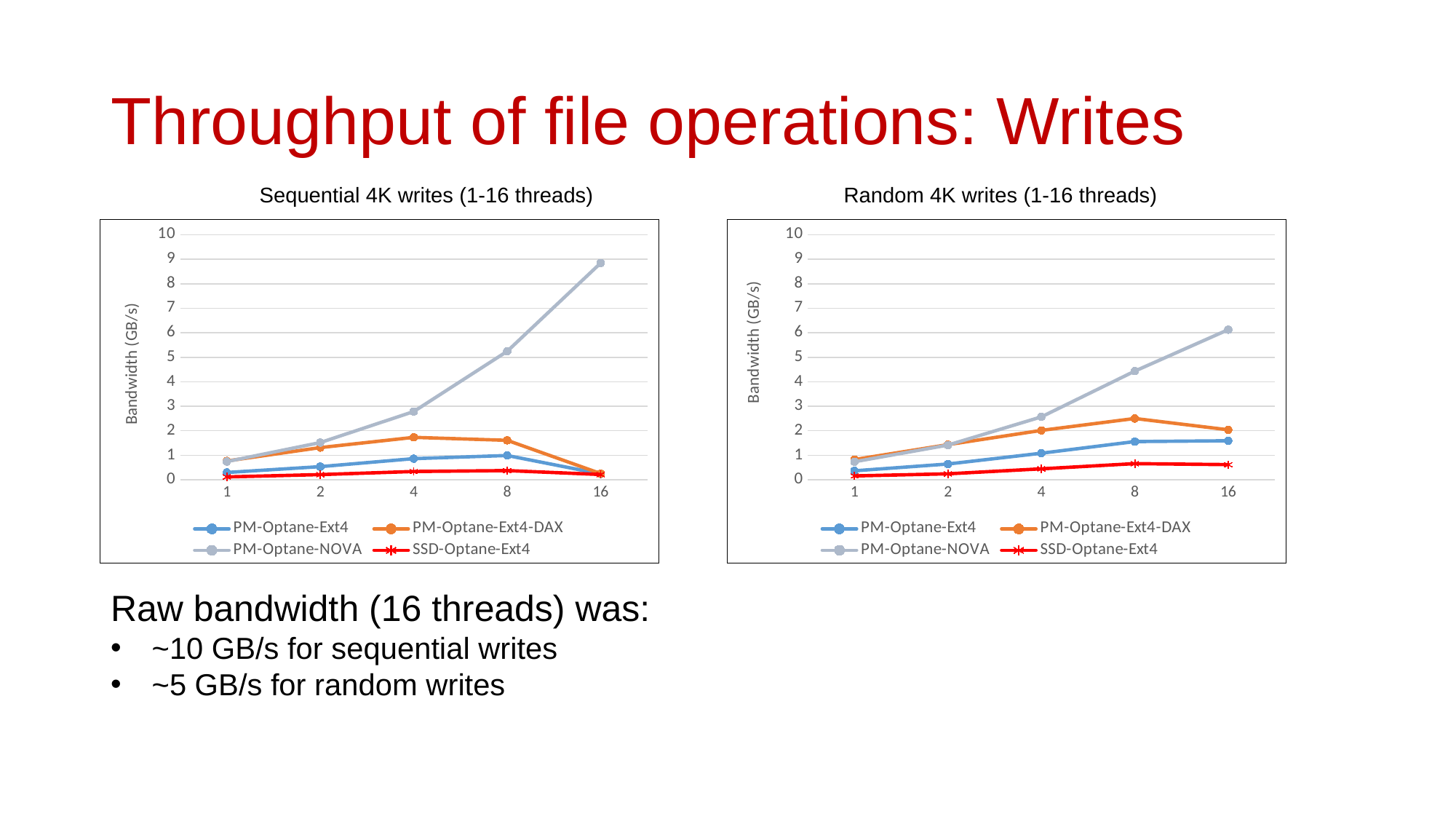
In the Sequential 4K writes (1-16 threads) chart, which series has the highest bandwidth at 16 threads? PM-Optane-NOVA How many series does the legend of the Random 4K writes (1-16 threads) chart list? 4 In the Sequential 4K writes (1-16 threads) chart, is the bandwidth of PM-Optane-NOVA at 16 threads greater or less than 8 GB/s? greater In the Random 4K writes (1-16 threads) chart, which series has the lowest bandwidth at 16 threads? SSD-Optane-Ext4 In the Random 4K writes (1-16 threads) chart, is the bandwidth of PM-Optane-Ext4-DAX at 8 threads greater or less than 2 GB/s? greater In the Sequential 4K writes (1-16 threads) chart, which has the higher bandwidth at 8 threads: PM-Optane-Ext4 or PM-Optane-Ext4-DAX? PM-Optane-Ext4-DAX How many thread-count points are plotted along the x axis of the Sequential 4K writes (1-16 threads) chart? 5 What kind of chart is the Sequential 4K writes (1-16 threads) chart? line chart In the Random 4K writes (1-16 threads) chart, is the bandwidth of SSD-Optane-Ext4 at 16 threads greater or less than 1 GB/s? less In the Sequential 4K writes (1-16 threads) chart, does the bandwidth of PM-Optane-Ext4-DAX rise or fall between 8 and 16 threads? fall What is the y-axis label of the Random 4K writes (1-16 threads) chart? Bandwidth (GB/s)